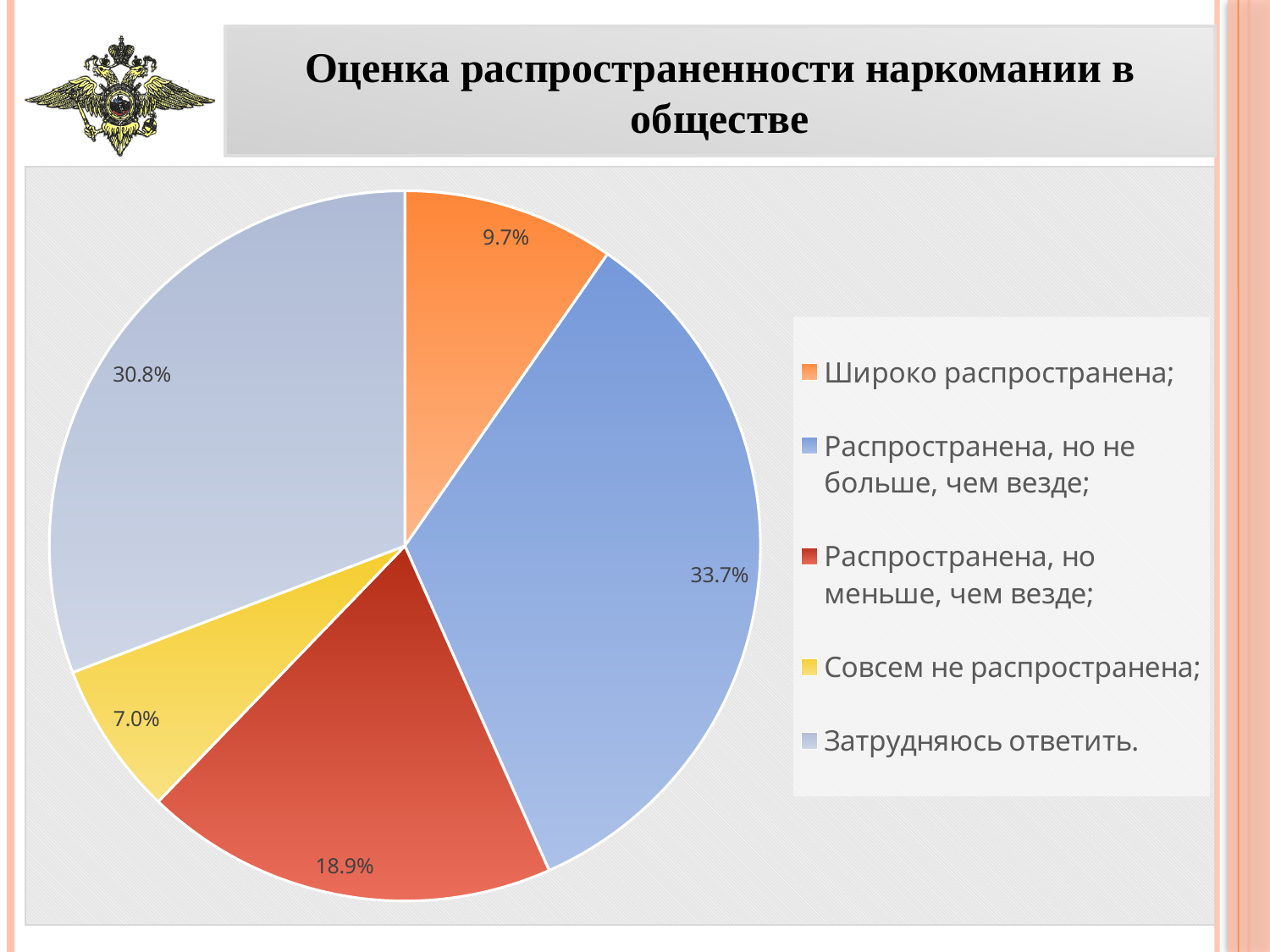
What is the value for "Распространена, но не больше, чем везде"? 33.7% How many categories does the pie chart have? 5 Which category has the largest share of the pie? Распространена, но не больше, чем везде What is the value for "Широко распространена"? 9.7% What is the value for "Совсем не распространена"? 7.0% Which category has the smallest share of the pie? Совсем не распространена What is the difference between the values for "Распространена, но не больше, чем везде" and "Затрудняюсь ответить"? 2.9% Which is larger: the value for "Распространена, но меньше, чем везде" or the value for "Широко распространена"? Распространена, но меньше, чем везде What is the value for "Распространена, но меньше, чем везде"? 18.9% What is the title of the chart on the slide? Оценка распространенности наркомании в обществе What kind of chart is shown on the slide? pie chart What is the value for "Затрудняюсь ответить"? 30.8%